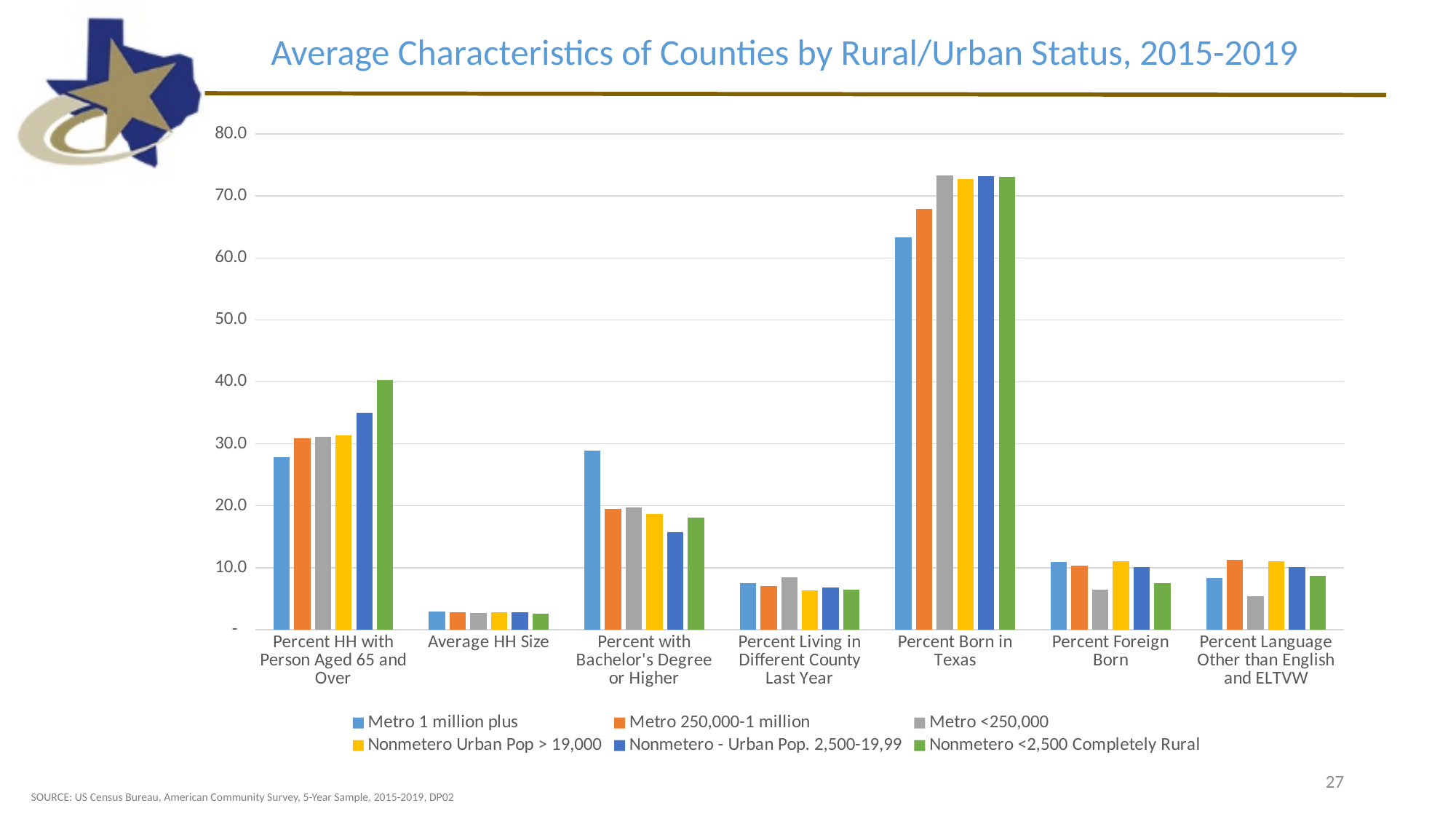
Which category has the tallest bars overall in the chart? Percent Born in Texas Within the 'Percent with Bachelor's Degree or Higher' group, which series has the lowest value? Nonmetero - Urban Pop. 2,500-19,99 Is the value for Metro 1 million plus in 'Percent Born in Texas' greater or less than 60.0? greater Within the 'Percent HH with Person Aged 65 and Over' group, which series has the highest value? Nonmetero <2,500 Completely Rural In 'Percent with Bachelor's Degree or Higher', which is larger: Metro 1 million plus or Metro 250,000-1 million? Metro 1 million plus How many categories are shown along the x axis of the chart? 7 Is the value for Metro 1 million plus in 'Percent with Bachelor's Degree or Higher' greater or less than 20.0? greater What is the title of the chart? Average Characteristics of Counties by Rural/Urban Status, 2015-2019 Within the 'Percent Language Other than English and ELTVW' group, which series has the lowest value? Metro <250,000 Is the value for Nonmetero <2,500 Completely Rural in 'Percent HH with Person Aged 65 and Over' greater or less than 30.0? greater What kind of chart is shown on the slide? bar chart How many series does the chart's legend list? 6